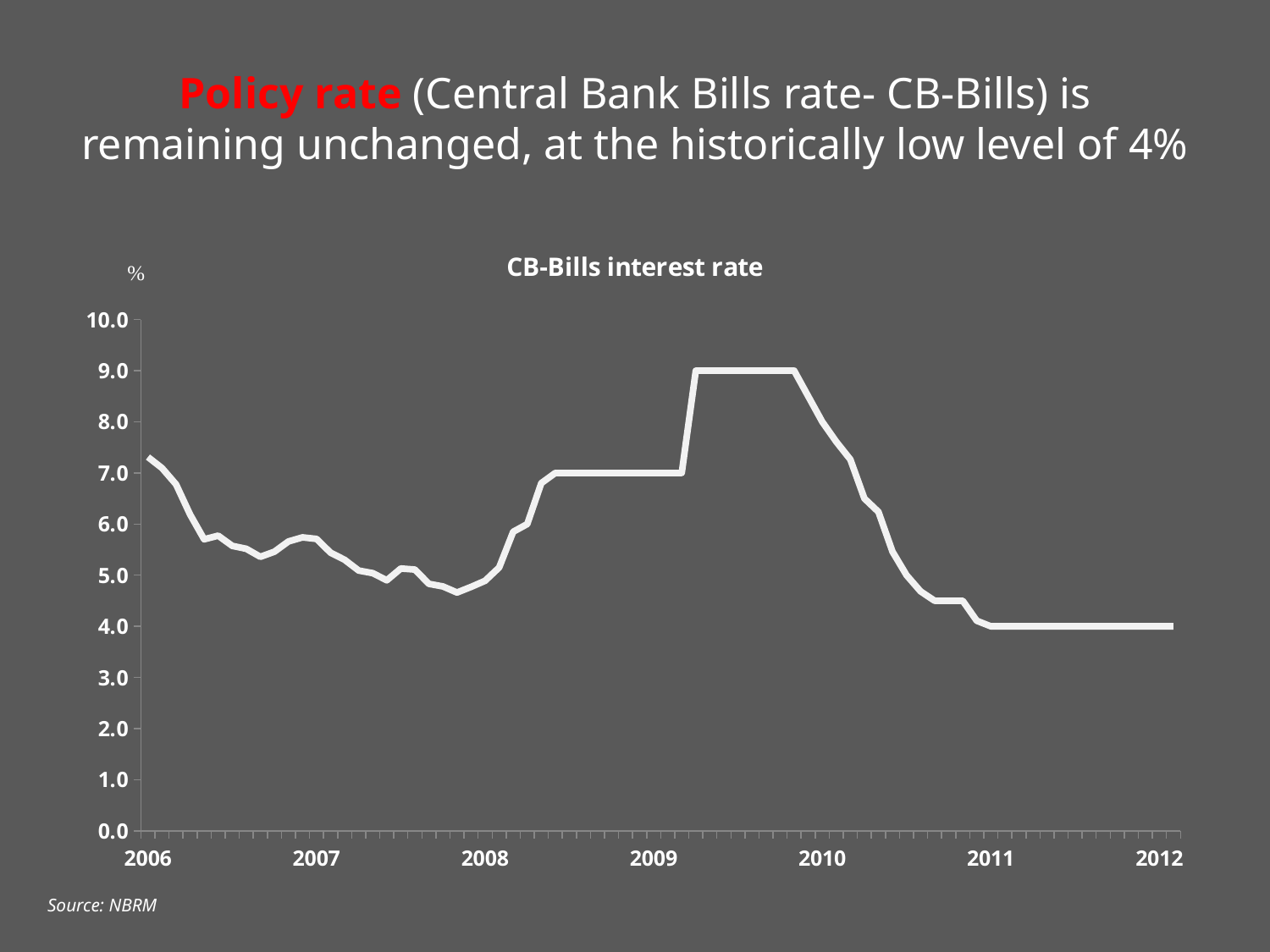
What kind of chart is shown on the slide? line chart What is the title of the chart? CB-Bills interest rate Is the CB-Bills interest rate at 2008 greater or less than 6.0? less What is the CB-Bills interest rate at 2009? 7.0 Is the CB-Bills interest rate at 2006 greater or less than 6.0? greater What is the CB-Bills interest rate at 2011? 4.0 What is the difference between the peak CB-Bills interest rate and the rate at 2012? 5.0 What is the CB-Bills interest rate at 2012, the end of the series? 4.0 Which is higher, the CB-Bills interest rate at 2009 or at 2011? 2009 How does the CB-Bills interest rate change between 2011 and 2012? It stays flat Is the CB-Bills interest rate at 2007 greater or less than 5.0? greater What is the highest level the CB-Bills interest rate reaches on the chart? 9.0